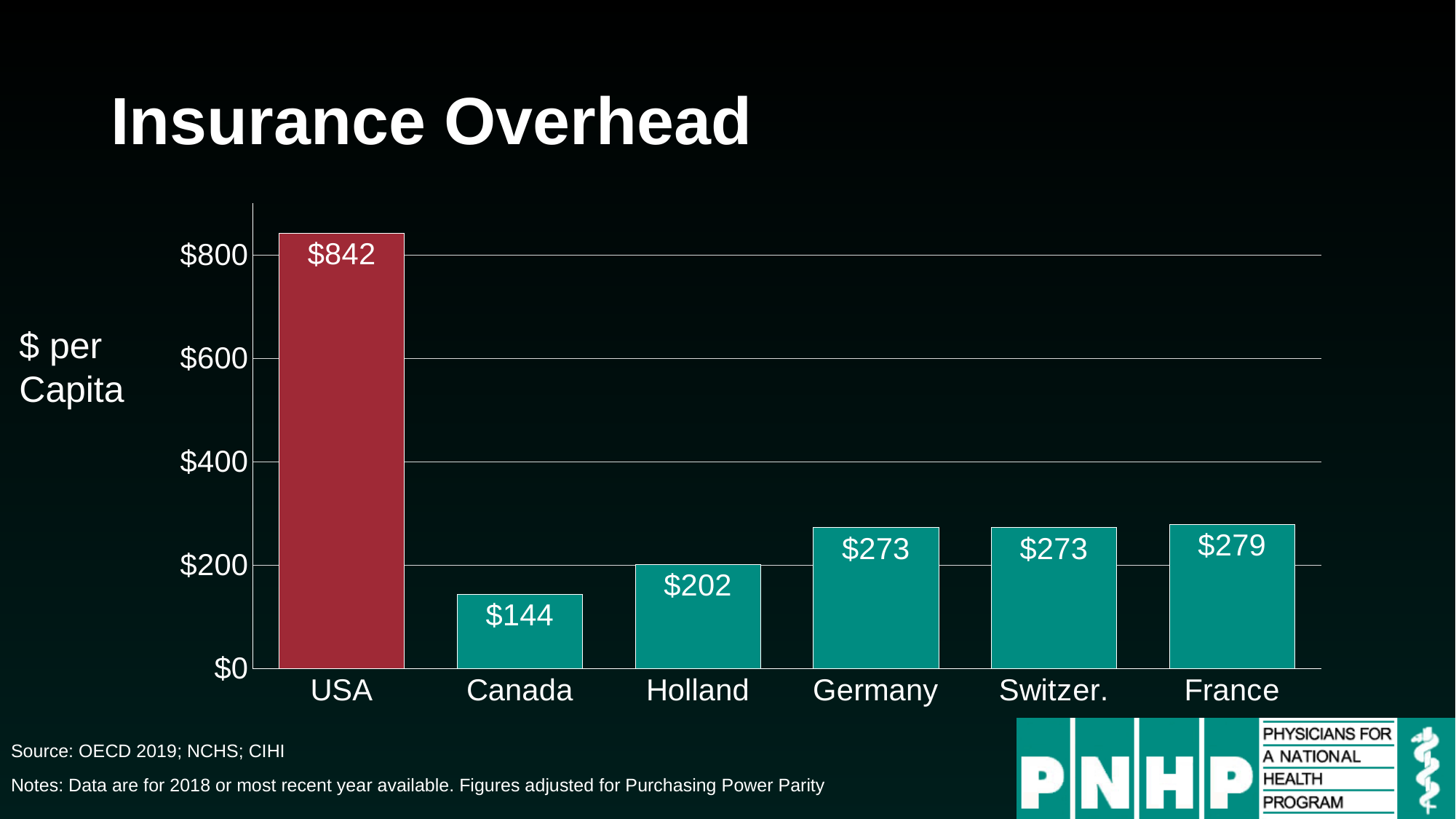
What type of chart is shown on the slide? Bar chart How many countries are shown in the chart? 6 What is the insurance overhead per capita for Holland? $202 What is the difference in insurance overhead per capita between France and Holland? $77 What is the insurance overhead per capita for Canada? $144 What is the difference in insurance overhead per capita between the USA and Canada? $698 Is the value for Switzer. greater or less than $400? less Which country has the highest insurance overhead per capita? USA Which has a higher insurance overhead per capita, Holland or Germany? Germany Which country has the lowest insurance overhead per capita? Canada What is the insurance overhead per capita for France? $279 What is the insurance overhead per capita for the USA? $842